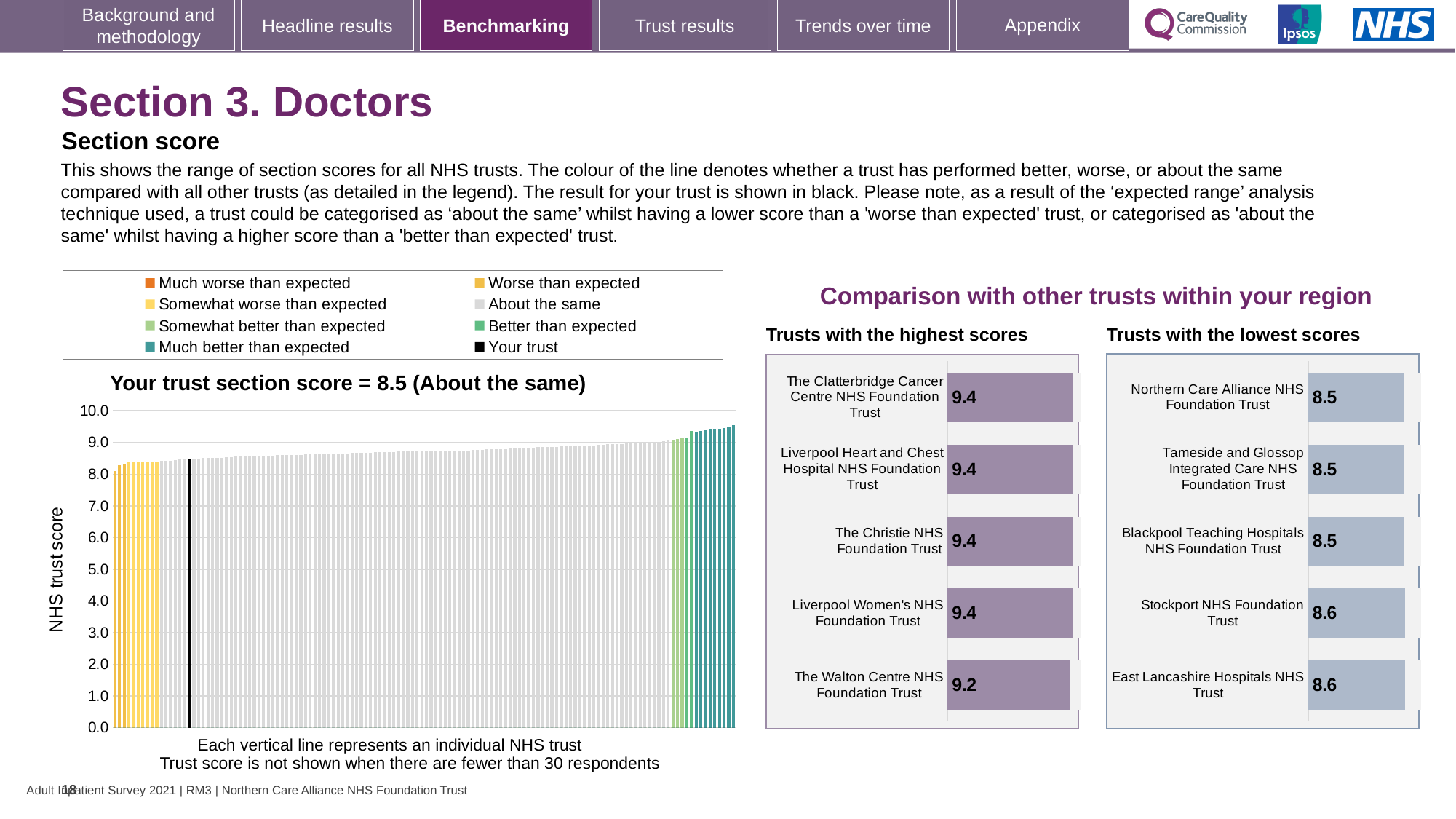
In the 'Your trust section score' chart, do the trust scores rise or fall from left to right along the x axis? rise In the 'Trusts with the lowest scores' chart, which is larger: the score for Stockport NHS Foundation Trust or the score for Northern Care Alliance NHS Foundation Trust? Stockport NHS Foundation Trust In the 'Your trust section score' chart, how many entries does the legend list? 8 In the 'Trusts with the highest scores' chart, which trust has the lowest score? The Walton Centre NHS Foundation Trust In the 'Trusts with the highest scores' chart, what is the score for The Walton Centre NHS Foundation Trust? 9.2 In the 'Trusts with the lowest scores' chart, what is the score for Stockport NHS Foundation Trust? 8.6 In the 'Your trust section score' chart, what is the section score for your trust? 8.5 In the 'Your trust section score' chart, what kind of chart is shown? bar chart In the 'Trusts with the highest scores' chart, how many trusts are shown? 5 In the 'Your trust section score' chart, is the value of the tallest bar on the right greater or less than 9.0? greater In the 'Your trust section score' chart, what category is your trust placed in? About the same In the 'Trusts with the highest scores' chart, what is the difference between the scores of The Clatterbridge Cancer Centre NHS Foundation Trust and The Walton Centre NHS Foundation Trust? 0.2